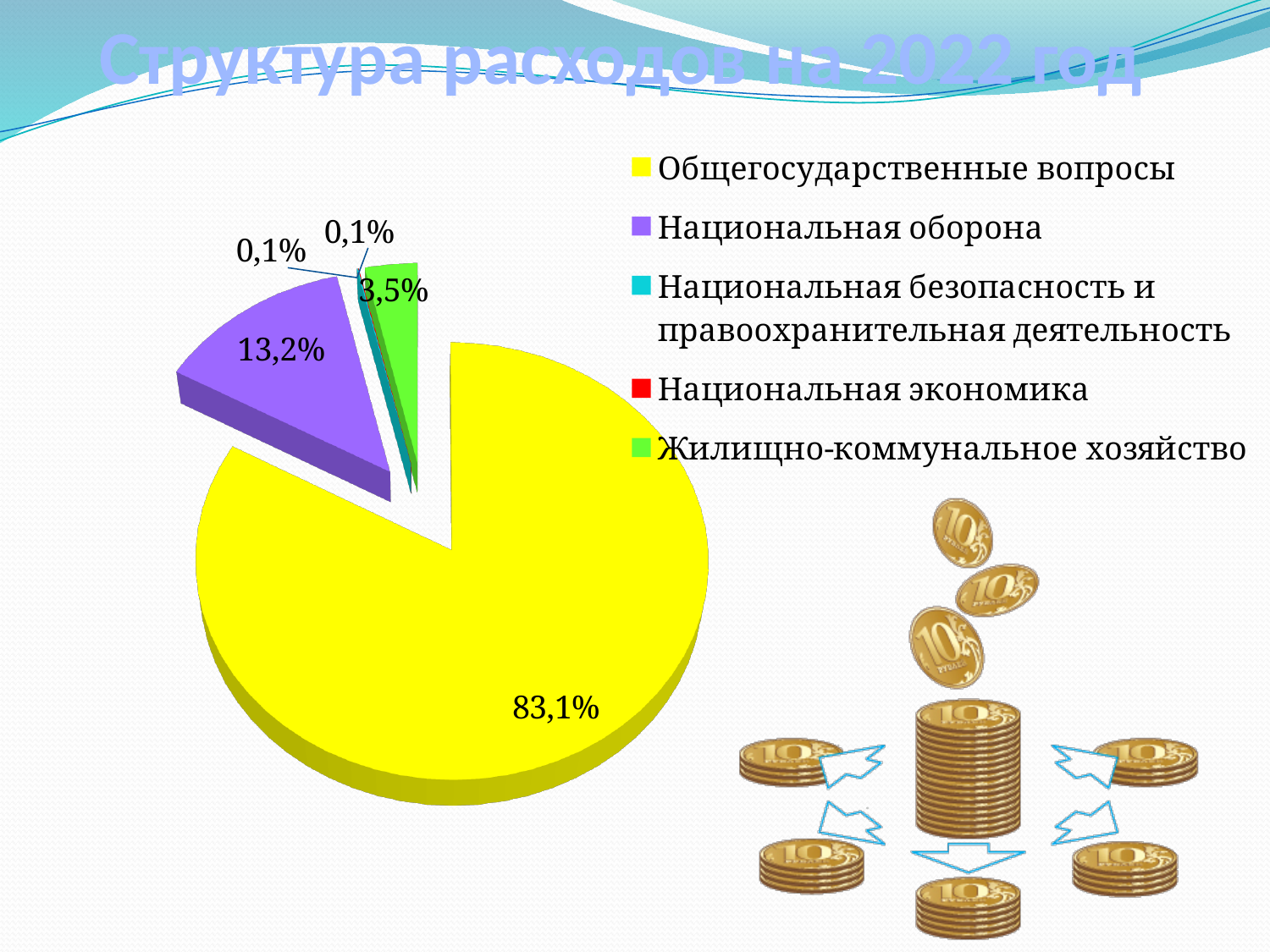
What is the difference in percentage points between the shares for Общегосударственные вопросы and Национальная оборона? 69,9 Which is larger: the share for Национальная оборона or the share for Жилищно-коммунальное хозяйство? Национальная оборона What share of expenditures is labelled for Национальная оборона? 13,2% What share of expenditures is labelled for Национальная экономика? 0,1% What share of expenditures is labelled for Жилищно-коммунальное хозяйство? 3,5% Which category has the largest share of the pie? Общегосударственные вопросы What share of expenditures is labelled for Национальная безопасность и правоохранительная деятельность? 0,1% What share of expenditures is labelled for Общегосударственные вопросы? 83,1% How many categories does the legend list? 5 What is the difference in percentage points between the shares for Национальная оборона and Жилищно-коммунальное хозяйство? 9,7 What kind of chart is shown on the slide? pie chart What is the title of the slide? Структура расходов на 2022 год